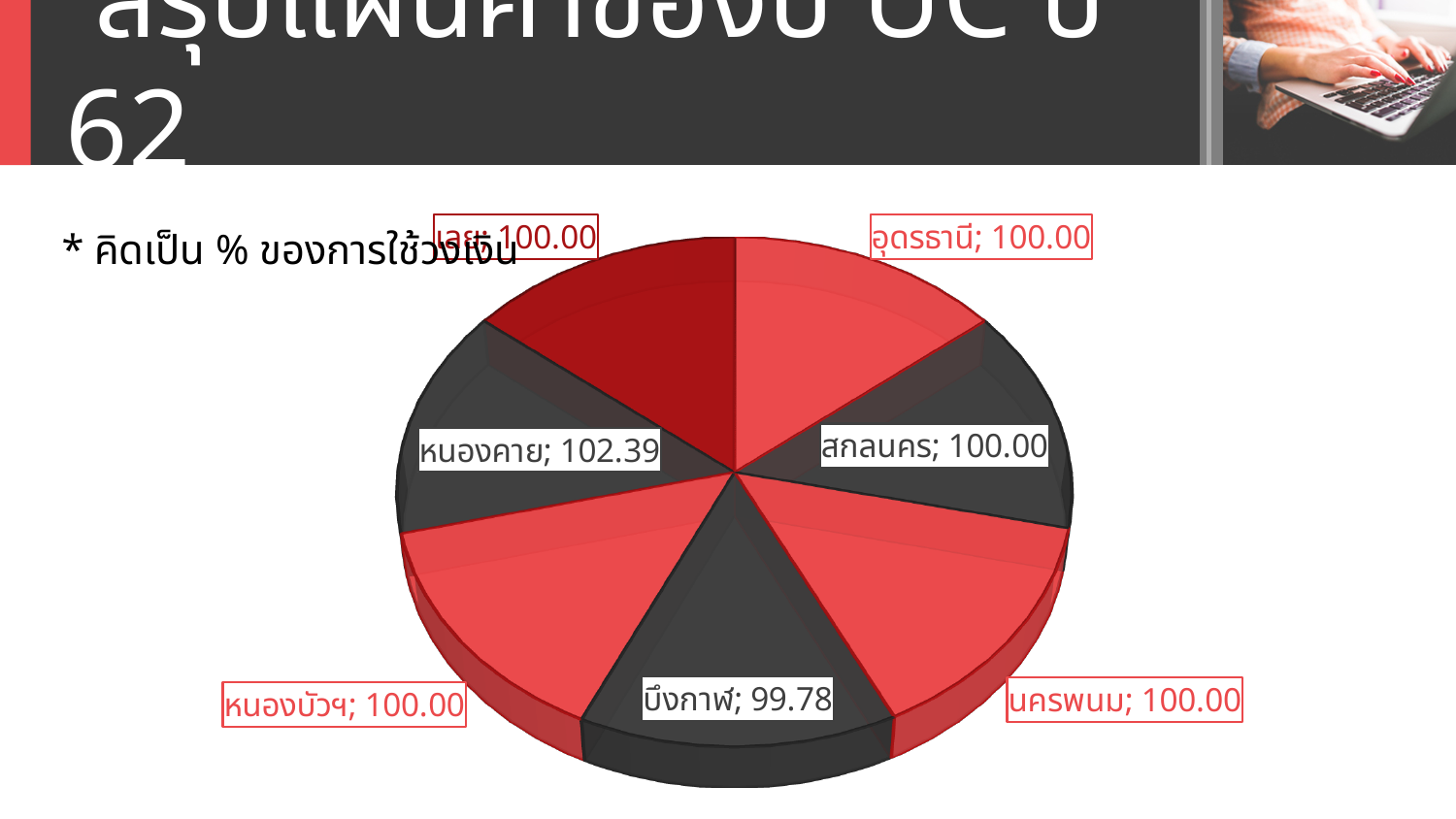
Which category has the highest value in the pie chart? หนองคาย According to the note on the slide, what do the values in the chart represent? % ของการใช้วงเงิน Which has the larger value, หนองคาย or เลย? หนองคาย How many slices does the pie chart have? 7 Which category has the lowest value in the pie chart? บึงกาฬ What kind of chart is shown on the slide? pie chart What is the value shown for นครพนม? 100.00 What is the value shown for อุดรธานี? 100.00 What is the value shown for หนองคาย? 102.39 What is the value shown for บึงกาฬ? 99.78 What is the difference between the values for หนองคาย and สกลนคร? 2.39 What is the difference between the values for หนองคาย and บึงกาฬ? 2.61